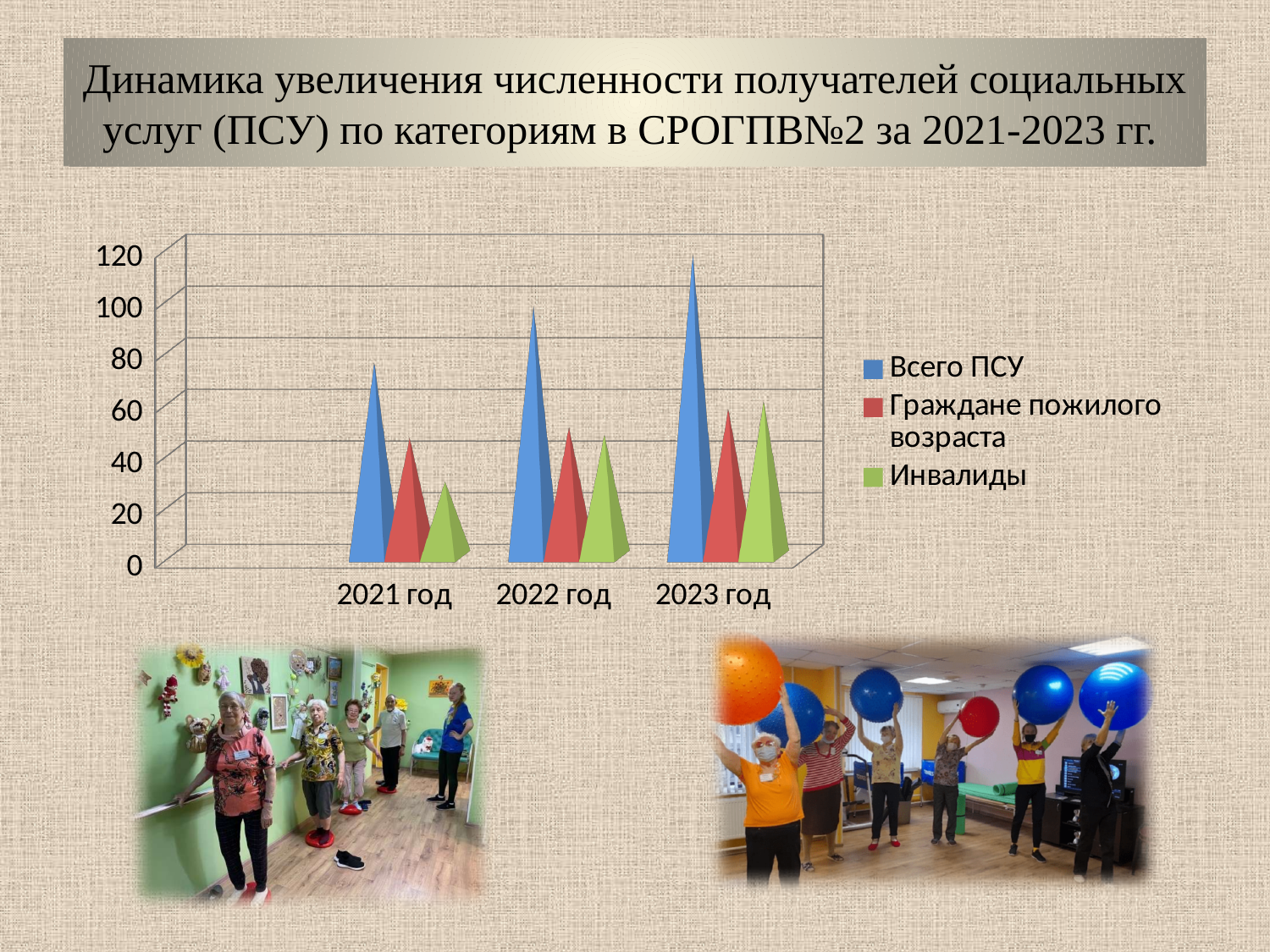
Is the value for Всего ПСУ in 2021 год greater or less than 60? greater In which year is the value for Инвалиды the lowest? 2021 год In 2021 год, which is larger: the value for Всего ПСУ or the value for Инвалиды? Всего ПСУ Does the value for Всего ПСУ rise or fall from 2021 год to 2023 год? rise What kind of chart is shown on the slide? bar chart Is the value for Всего ПСУ in 2022 год greater or less than 80? greater In which year is the value for Всего ПСУ the highest? 2023 год How many year categories are shown on the x axis of the chart? 3 Is the value for Инвалиды in 2021 год greater or less than 40? less Which series is shown in blue in the chart legend? Всего ПСУ How many series does the chart legend list? 3